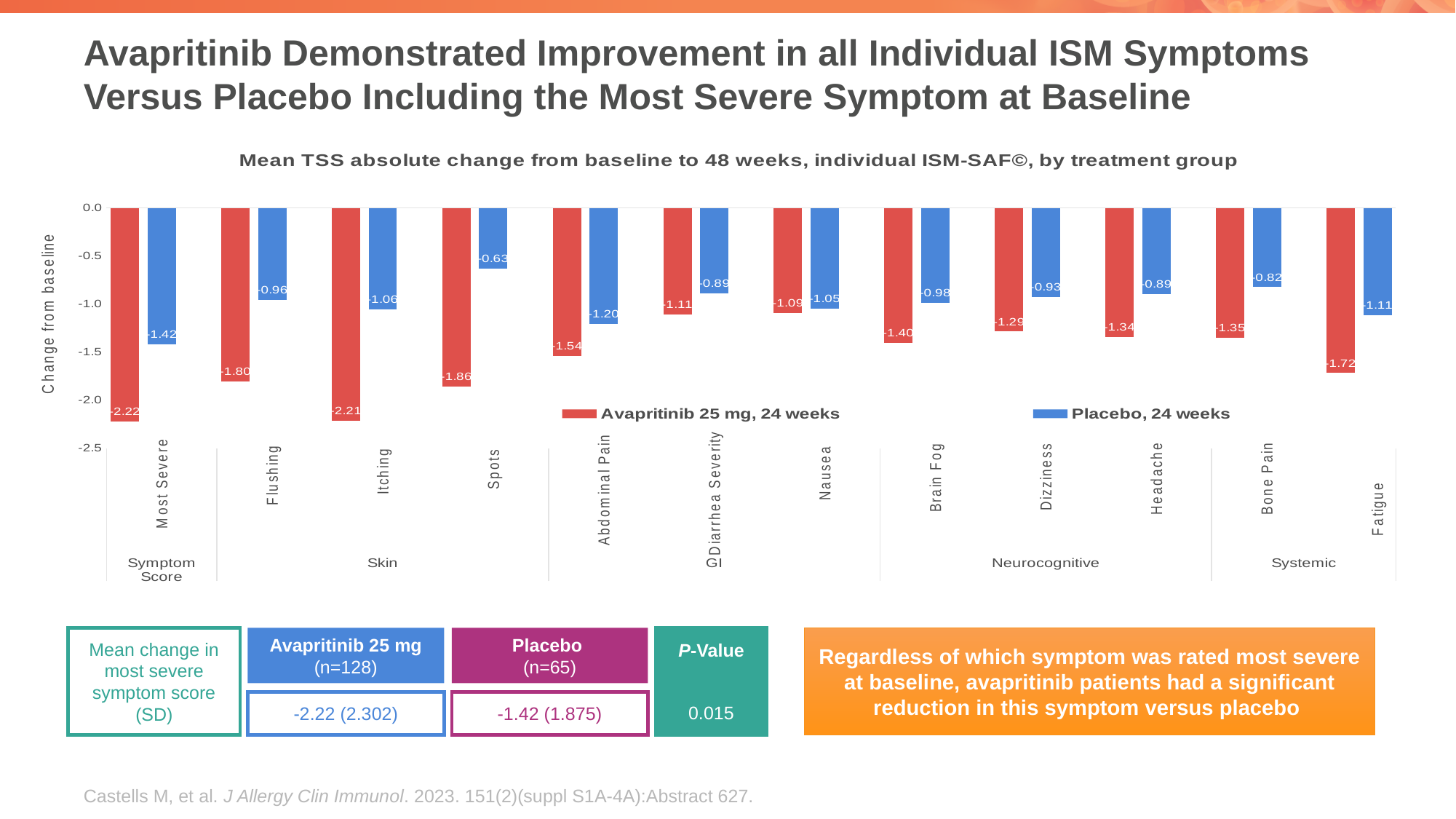
What kind of chart is shown on the slide? bar chart What is the mean change from baseline for Placebo in the Abdominal Pain category? -1.20 For the Placebo series, which category shows the smallest reduction from baseline (value closest to zero)? Spots For the Placebo series, which category shows the largest reduction from baseline (most negative value)? Most Severe How many series does the chart legend list? 2 Is the Avapritinib 25 mg value for Itching greater or less than -2.0? less In the Most Severe category, what is the difference between the Avapritinib 25 mg value (-2.22) and the Placebo value (-1.42)? 0.80 How many symptom categories are plotted on the x axis of the chart? 12 What is the mean change from baseline for Avapritinib 25 mg in the Fatigue category? -1.72 In the Spots category, which treatment group shows the larger reduction from baseline? Avapritinib 25 mg, 24 weeks What is the mean change from baseline for Avapritinib 25 mg in the Flushing category? -1.80 What is the mean change from baseline for Placebo in the Spots category? -0.63